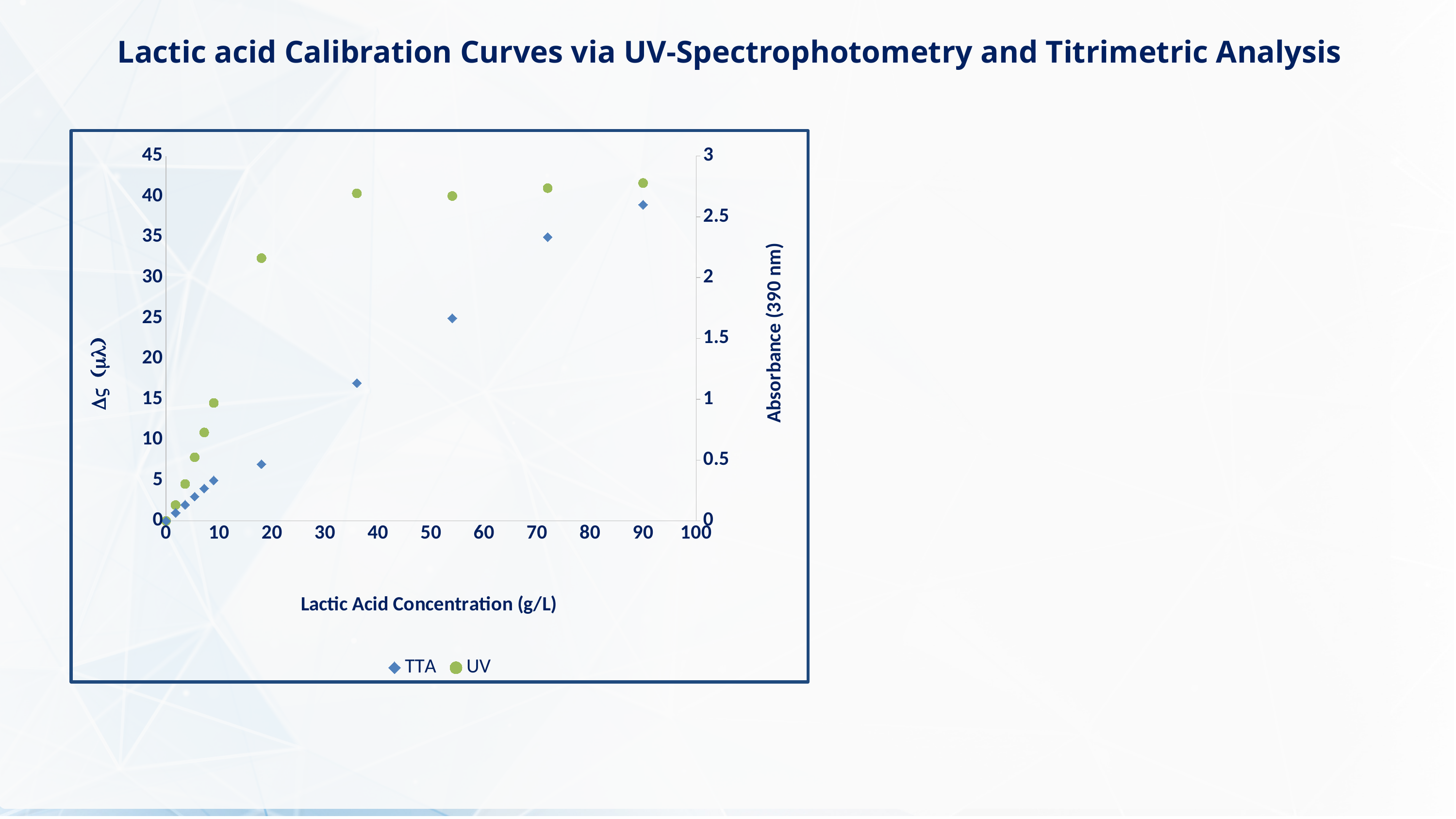
What is the title of the right-hand vertical axis? Absorbance (390 nm) Do the UV absorbance values rise or fall as lactic acid concentration increases? rise Do the TTA values rise or fall as lactic acid concentration increases? rise What kind of chart is shown on the slide? scatter chart Is the TTA value at 90 g/L greater or less than 35? greater Is the TTA value at 36 g/L greater or less than 20? less Is the UV absorbance at 18 g/L greater or less than 2? greater What are the two series named in the legend? TTA and UV At which lactic acid concentration is the TTA value highest? 90 g/L How many series does the legend list? 2